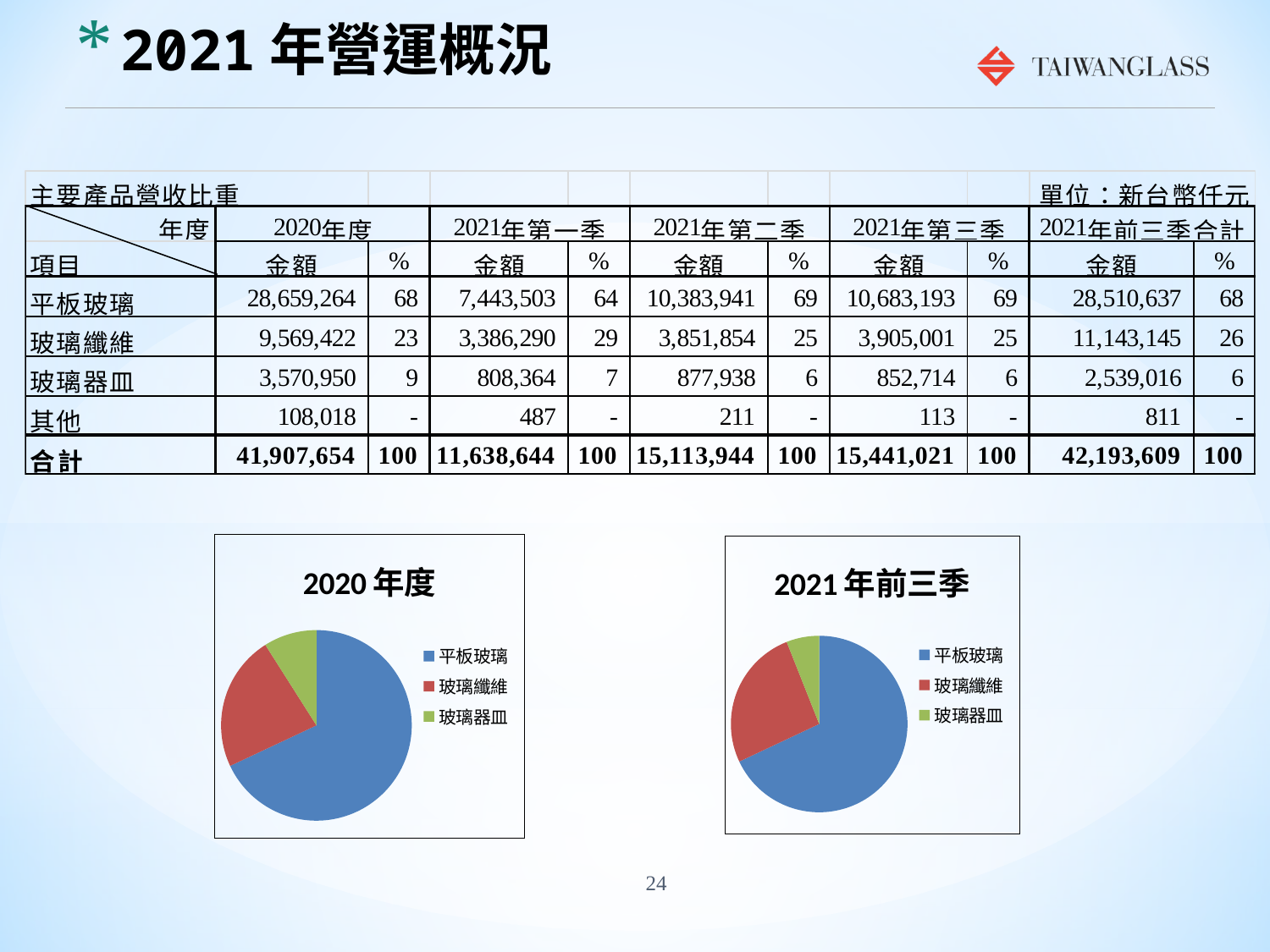
In the "2020 年度" chart, which category has the largest slice? 平板玻璃 In the "2021 年前三季" chart, what colour is the 平板玻璃 slice? blue What kind of chart is the "2020 年度" chart? pie chart What is the title of the pie chart on the left of the slide? 2020 年度 What kind of chart is the "2021 年前三季" chart? pie chart In the "2021 年前三季" chart, which slice is larger, 平板玻璃 or 玻璃纖維? 平板玻璃 In the "2021 年前三季" chart, which category has the smallest slice? 玻璃器皿 In the "2020 年度" chart, how many slices does the pie have? 3 In the "2021 年前三季" chart, which category has the largest slice? 平板玻璃 In the "2021 年前三季" chart, how many entries does the legend list? 3 In the "2020 年度" chart, which category has the smallest slice? 玻璃器皿 In the "2020 年度" chart, which slice is larger, 玻璃纖維 or 玻璃器皿? 玻璃纖維